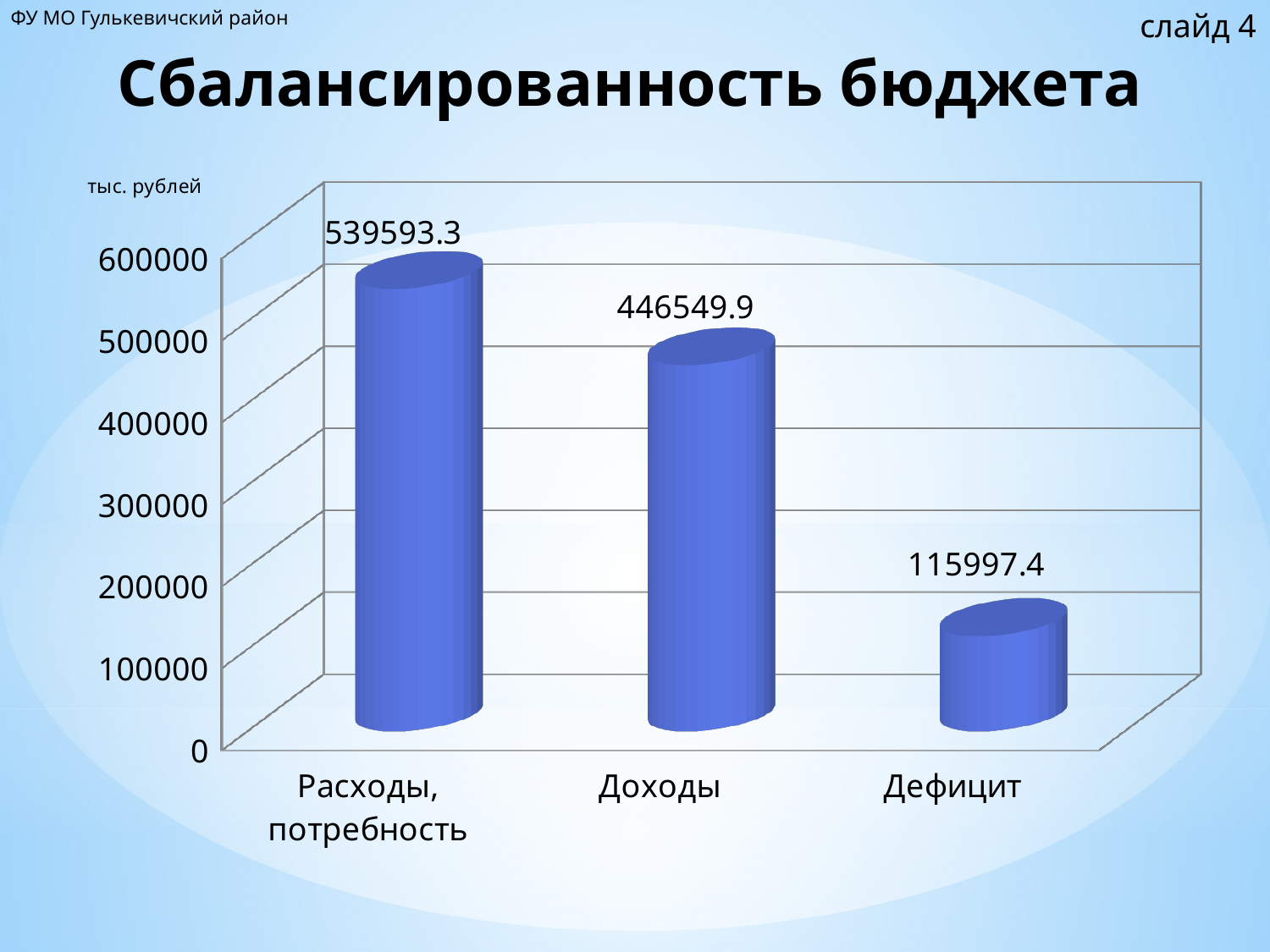
What is the difference between the values for Расходы, потребность and Доходы? 93043.4 What unit is indicated for the values on the chart? тыс. рублей How many categories are shown on the chart? 3 Which category has the highest value? Расходы, потребность What is the value for Доходы? 446549.9 What is the difference between the values for Доходы and Дефицит? 330552.5 What is the value for Расходы, потребность? 539593.3 Is the value for Доходы greater or less than 400000? greater Which category has the lowest value? Дефицит Which is larger, the value for Доходы or the value for Дефицит? Доходы What kind of chart is shown on the slide? bar chart What is the value for Дефицит? 115997.4